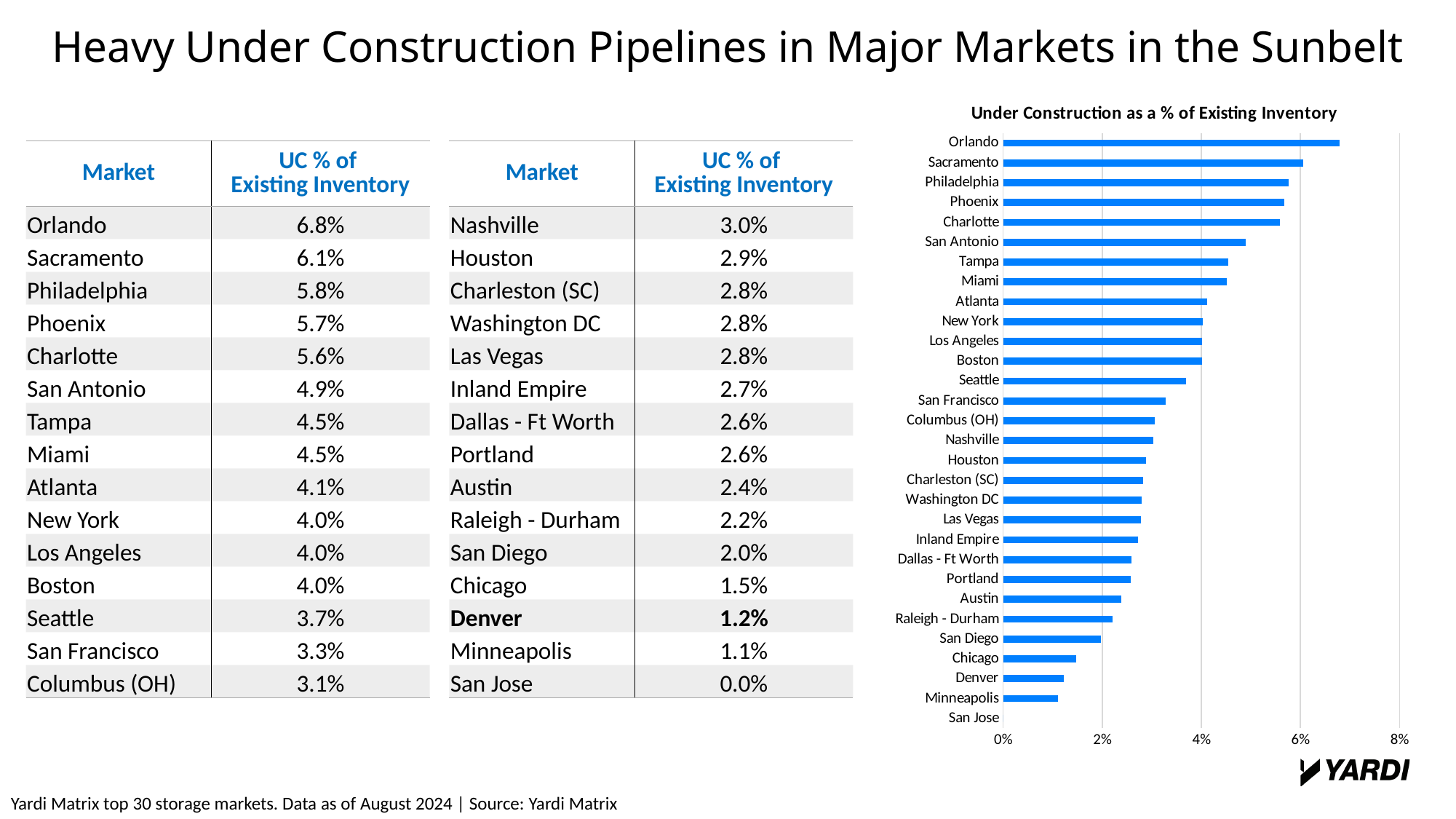
Is the value for Chicago greater or less than 2%? less Which market has the lowest under construction percentage of existing inventory? San Jose Which market has the highest under construction percentage of existing inventory? Orlando What is the under construction percentage of existing inventory for Denver? 1.2% What kind of chart is shown on the slide? bar chart Do the bar values increase or decrease going from the top of the chart to the bottom? decrease By how many percentage points does Orlando's value exceed Sacramento's? 0.7 percentage points How many markets are plotted in the bar chart? 30 What is the title of the chart on the right of the slide? Under Construction as a % of Existing Inventory What is the under construction percentage of existing inventory for Nashville? 3.0% What is the under construction percentage of existing inventory for Orlando? 6.8% Which has a higher under construction percentage, Phoenix or Seattle? Phoenix